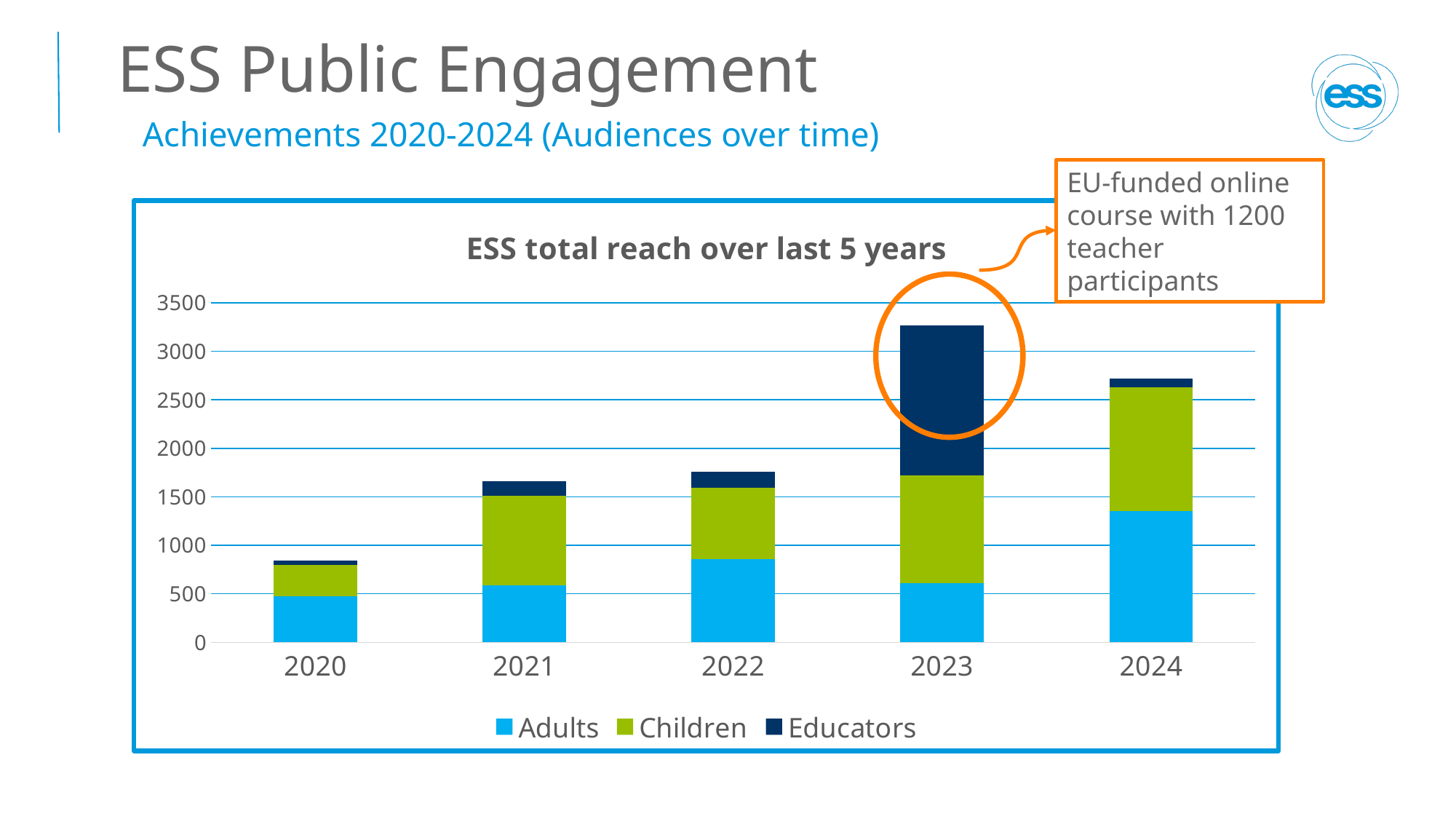
Which year has the larger total reach, 2022 or 2024? 2024 Is the total reach for 2020 greater or less than 1000? less How many years are shown on the x axis? 5 What kind of chart is shown on the slide? Stacked bar chart Which year has the highest total reach? 2023 Does the total reach rise or fall from 2020 to 2023? rise Is the total reach for 2023 greater or less than 3000? greater What is the title of the chart? ESS total reach over last 5 years How many series does the legend list? 3 Which year has the lowest total reach? 2020 Is the total reach for 2022 greater or less than 2000? less